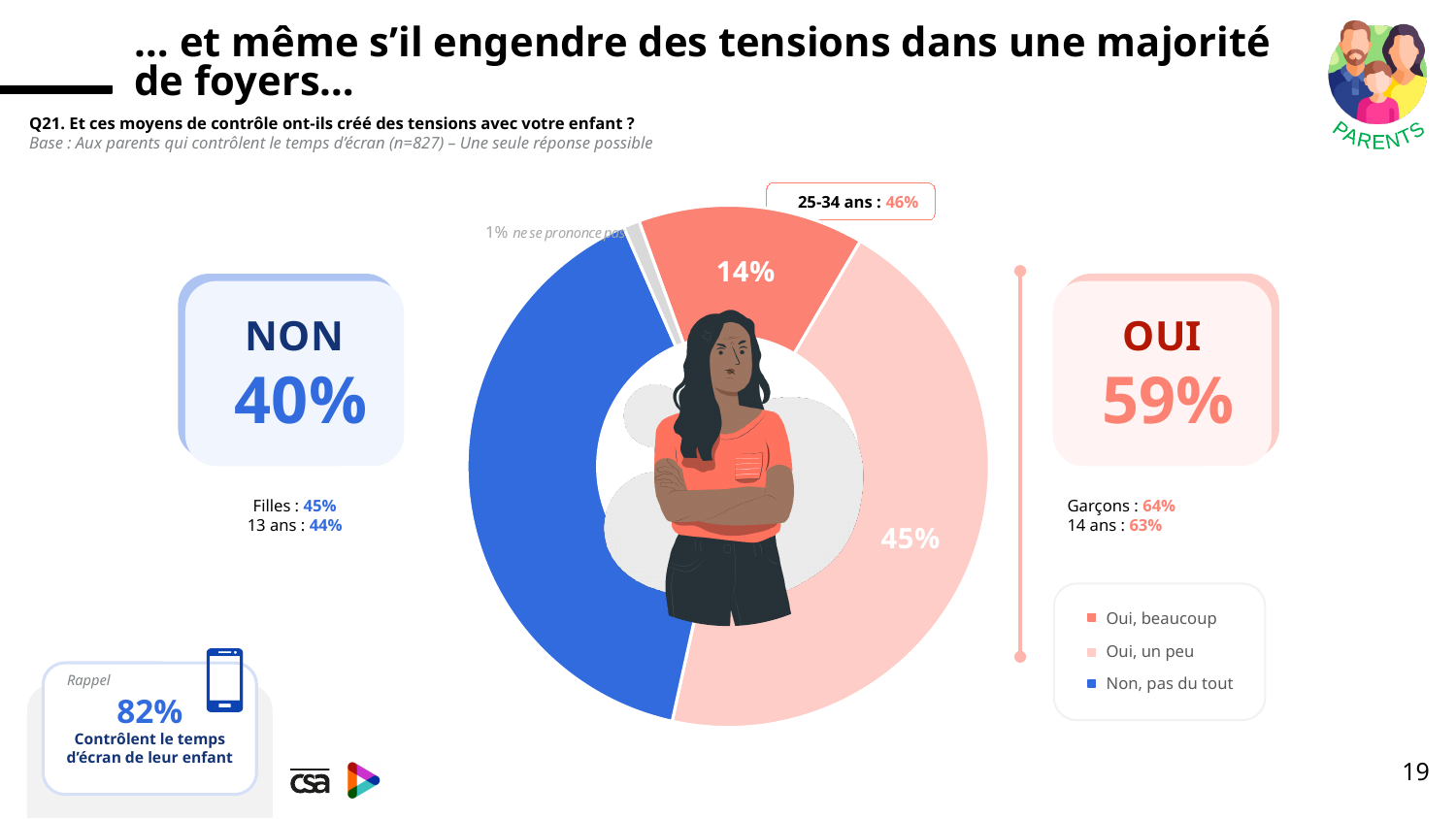
What percentage of parents "ne se prononce pas"? 1% What percentage of parents answered "Oui, beaucoup"? 14% What is the OUI share among parents of garçons? 64% Which response has the largest slice of the chart? Oui, un peu Which response has the smallest slice of the chart? Ne se prononce pas Which is larger: "Oui, beaucoup" or "Oui, un peu"? Oui, un peu What is the total share of parents who answered OUI? 59% What percentage of parents answered "Oui, un peu"? 45% What is the difference in percentage points between "Oui, un peu" and "Oui, beaucoup"? 31 percentage points How many entries does the legend list? 3 What kind of chart is shown on the slide? Pie chart (donut) What is the share of parents who answered NON? 40%